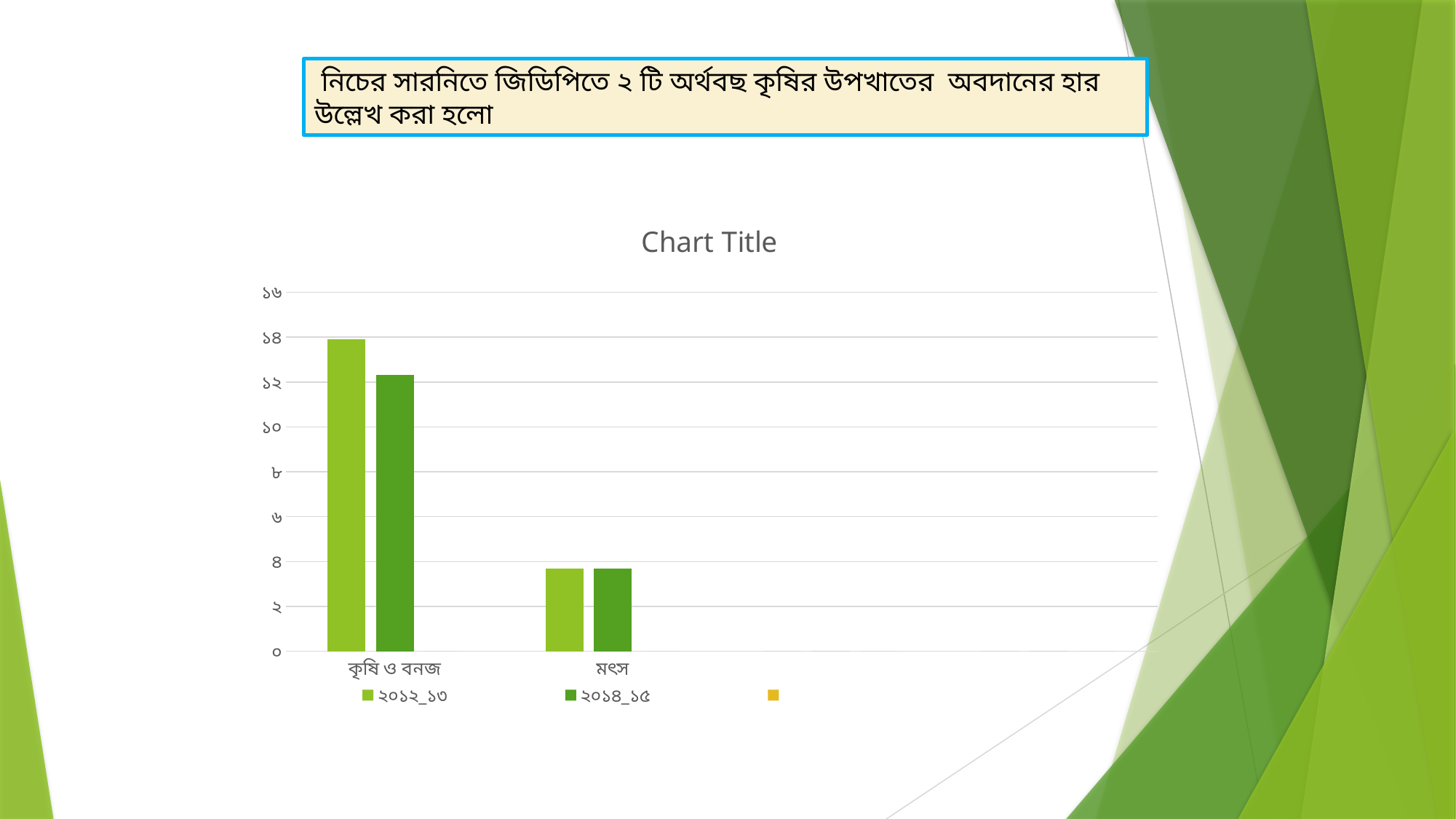
Is the value for কৃষি ও বনজ in ২০১৪_১৫ greater or less than ১০? greater Is the value for মৎস in ২০১৪_১৫ greater or less than ২? greater What is the title of the chart? Chart Title For the ২০১২_১৩ series, do the values rise or fall from কৃষি ও বনজ to মৎস? fall For কৃষি ও বনজ, which series has the larger value, ২০১২_১৩ or ২০১৪_১৫? ২০১২_১৩ Is the value for মৎস in ২০১২_১৩ greater or less than ৪? less How many categories are shown on the x axis of the chart? 2 Which series is shown in the lighter green colour? ২০১২_১৩ What kind of chart is shown on the slide? bar chart Which category has the highest bar in the chart? কৃষি ও বনজ How many named series does the chart legend list? 2